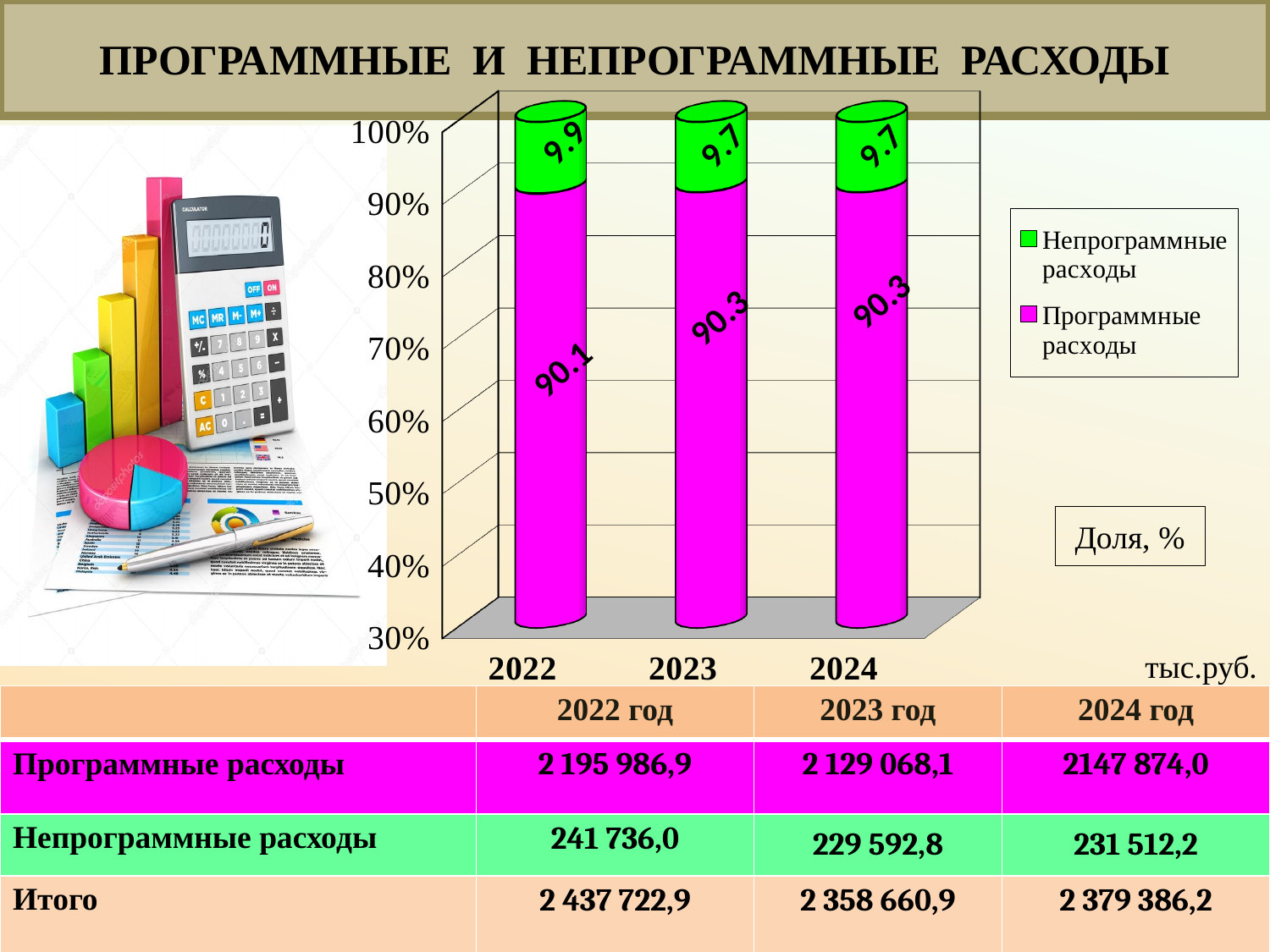
How many series does the chart legend list? 2 What share does the chart show for Программные расходы in 2022? 90.1 What share does the chart show for Программные расходы in 2024? 90.3 In which year is the share of Программные расходы lowest? 2022 Which is larger in 2024: the share of Программные расходы or Непрограммные расходы? Программные расходы What kind of chart is shown on the slide? Stacked bar chart What share does the chart show for Непрограммные расходы in 2022? 9.9 In which year is the share of Непрограммные расходы highest? 2022 What share does the chart show for Непрограммные расходы in 2023? 9.7 How many years are shown on the x axis of the chart? 3 Which colour represents Непрограммные расходы in the chart? Green What is the difference between the Программные расходы share in 2023 and in 2022? 0.2